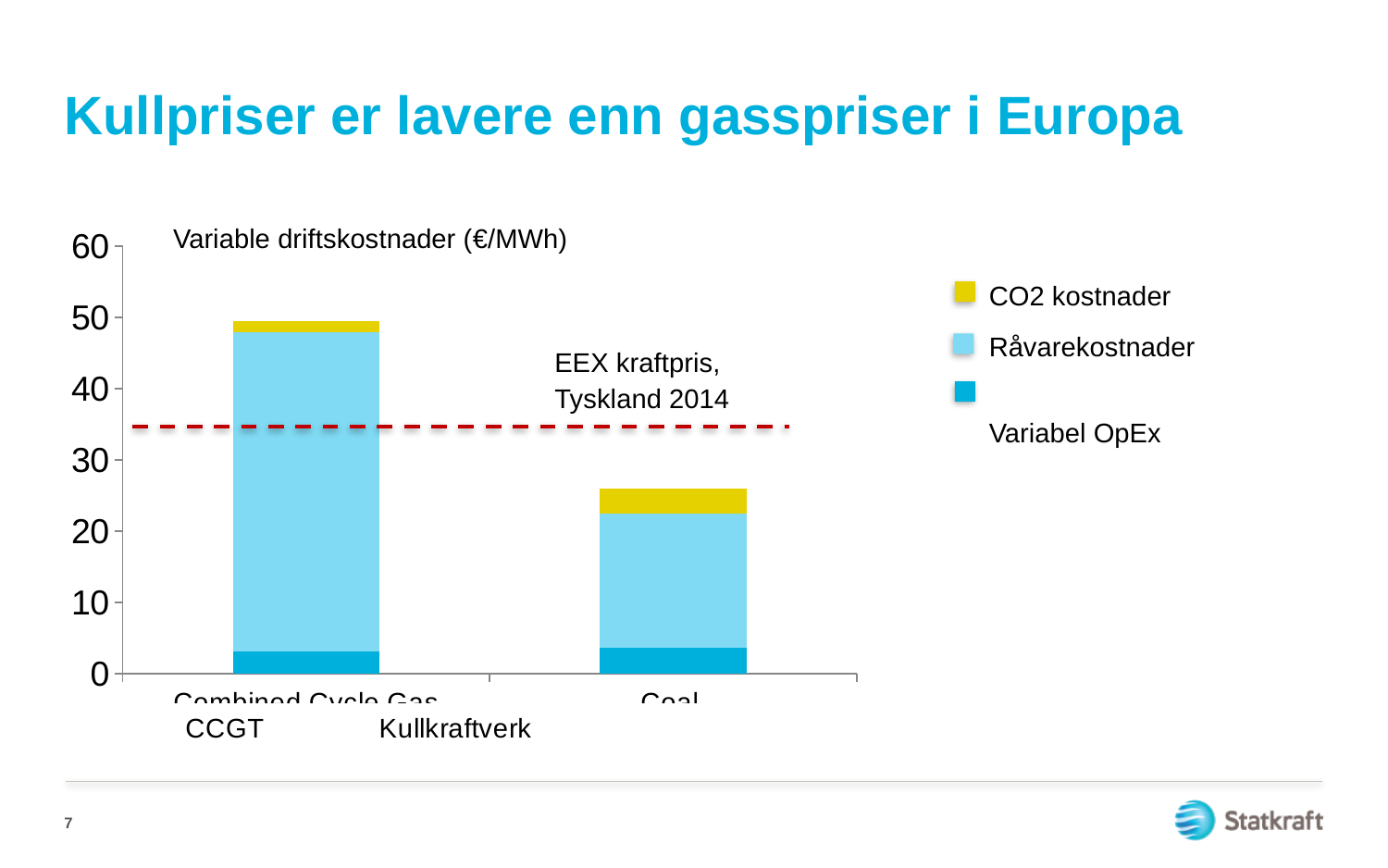
Is the total value for Kullkraftverk greater or less than 30? less Which category has the larger CO2 kostnader segment? Kullkraftverk Is the total value for Kullkraftverk greater or less than 20? greater Which has a larger total bar, CCGT or Kullkraftverk? CCGT Which category has the highest total variable operating cost? CCGT How many series does the legend list? 3 What unit is given in the chart's axis title? €/MWh What kind of chart is shown on the slide? Stacked bar chart Is the total value for CCGT greater or less than 40? greater Which category has the lowest total variable operating cost? Kullkraftverk How many categories (bars) are shown in the chart? 2 What does the red dashed horizontal line represent? EEX kraftpris, Tyskland 2014